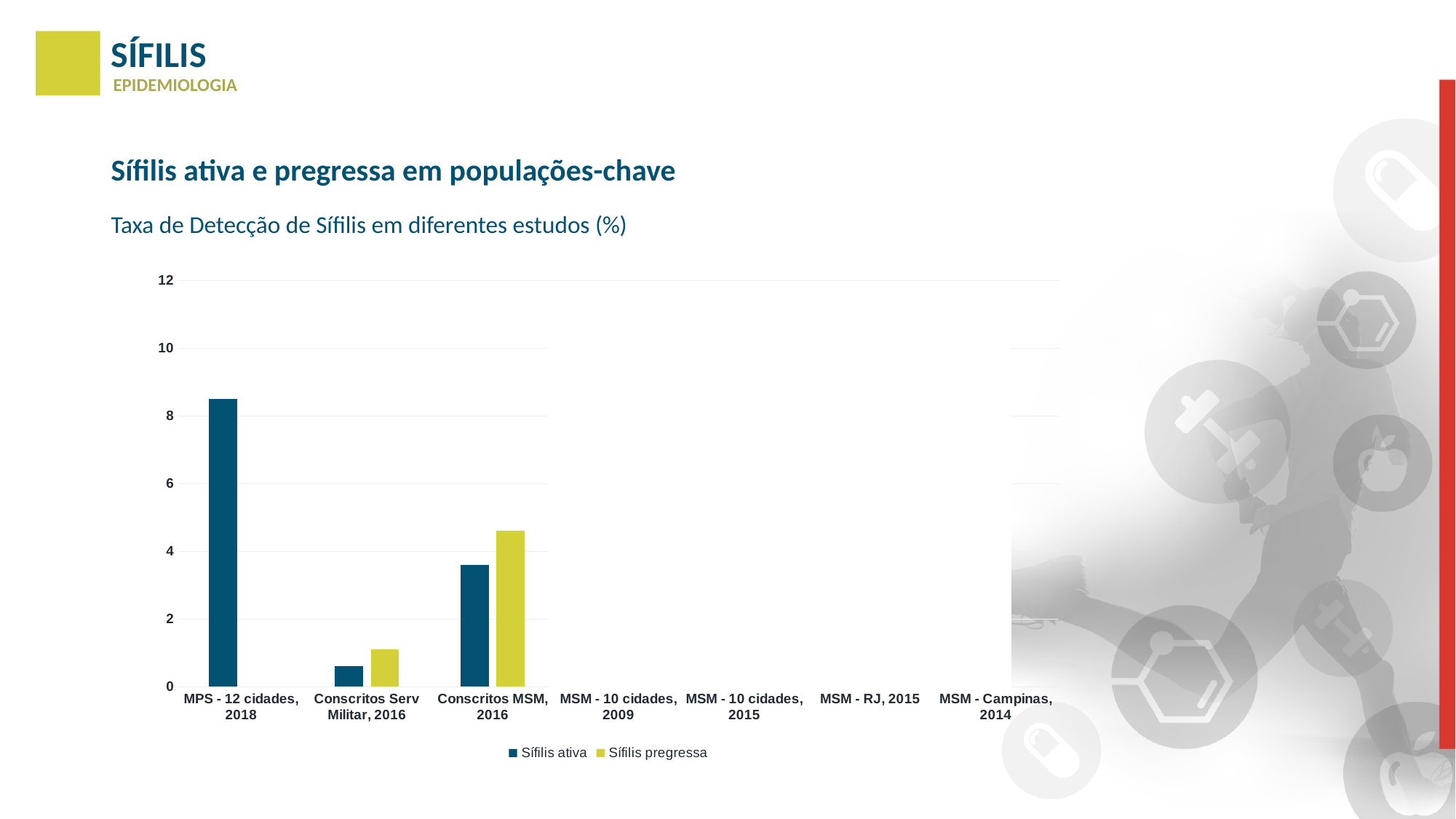
Which category has the highest Sífilis ativa value? MPS - 12 cidades, 2018 What is the subtitle describing the chart's data? Taxa de Detecção de Sífilis em diferentes estudos (%) Is the Sífilis pregressa value for Conscritos MSM, 2016 greater or less than 4? greater How many categories are shown on the x axis of the chart? 7 For Conscritos MSM, 2016, which is larger: Sífilis ativa or Sífilis pregressa? Sífilis pregressa What kind of chart is shown on the slide? bar chart Is the Sífilis pregressa value for Conscritos Serv Militar, 2016 greater or less than 2? less How many series does the legend list? 2 Is the Sífilis ativa value for Conscritos MSM, 2016 greater or less than 4? less Which series is shown in yellow-green in the chart? Sífilis pregressa For Conscritos Serv Militar, 2016, which is larger: Sífilis ativa or Sífilis pregressa? Sífilis pregressa